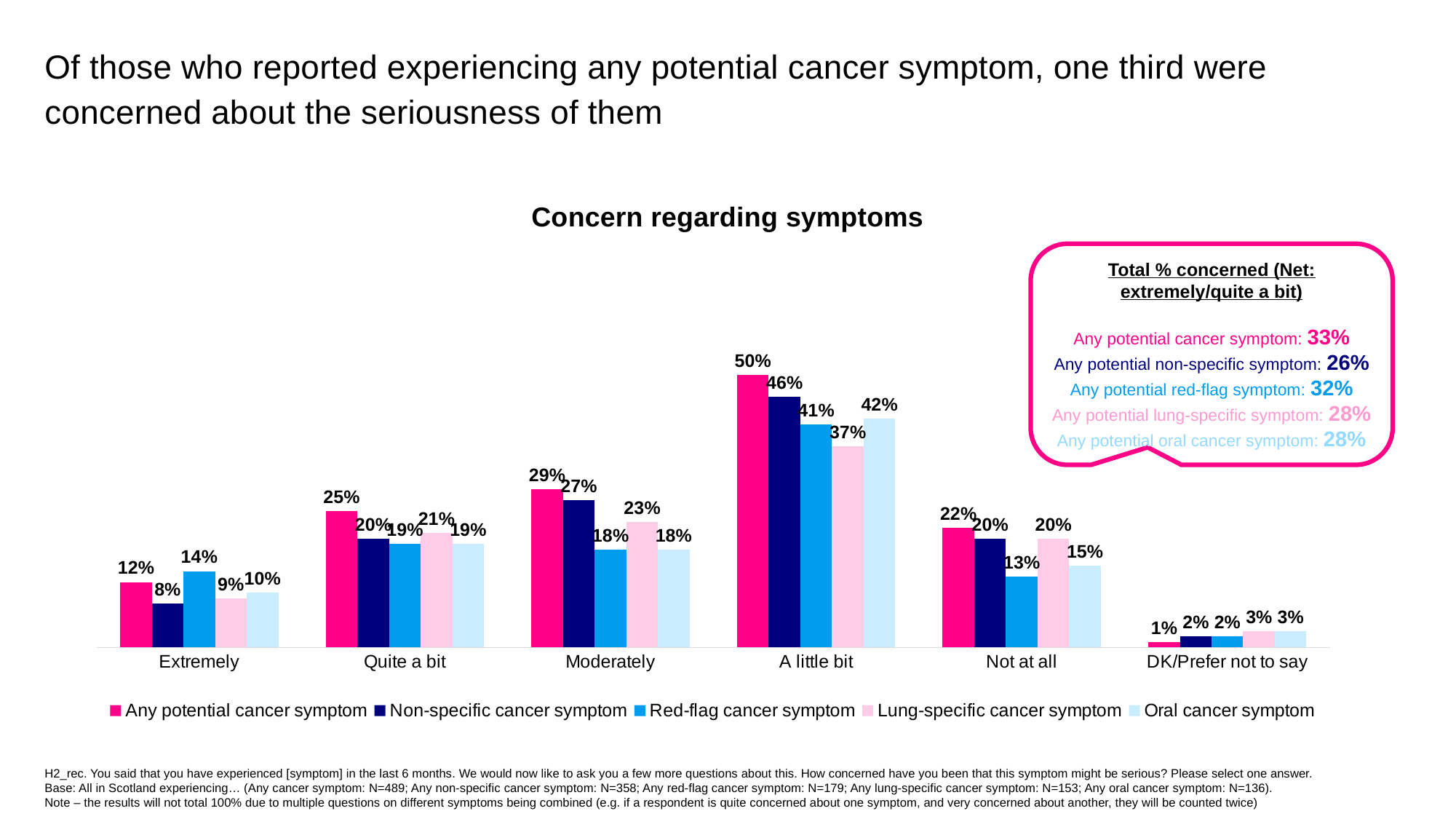
Which category has the lowest value for Any potential cancer symptom? DK/Prefer not to say What kind of chart is shown? Bar chart How many series does the legend list? 5 What is the value for Red-flag cancer symptom in the Extremely category? 14% What is the value for Oral cancer symptom in the Not at all category? 15% Which category has the highest value for Non-specific cancer symptom? A little bit What is the difference between Any potential cancer symptom and Lung-specific cancer symptom in the A little bit category? 13% What is the value for Any potential cancer symptom in the A little bit category? 50% What is the title of the chart? Concern regarding symptoms How many categories are shown on the x axis? 6 In the Not at all category, which is larger: Red-flag cancer symptom or Lung-specific cancer symptom? Lung-specific cancer symptom What is the value for Lung-specific cancer symptom in the Moderately category? 23%